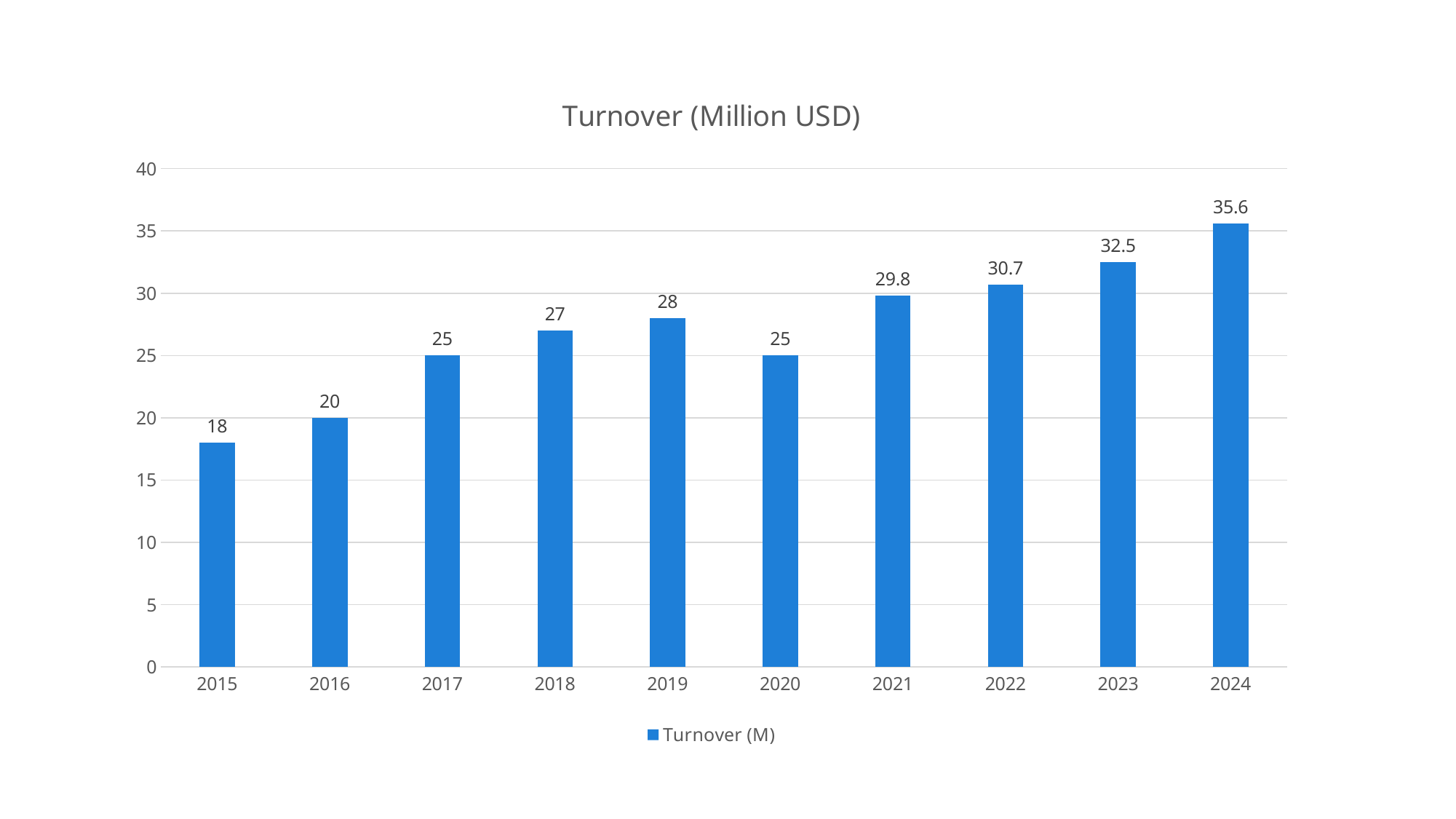
What is the turnover value for 2022? 30.7 How many years are shown on the x axis? 10 How many series does the legend list? 1 What is the difference between the turnover in 2018 and the turnover in 2015? 9 Which year has the lowest turnover? 2015 Which year has a larger turnover, 2019 or 2020? 2019 What is the turnover value for 2019? 28 What kind of chart is shown on the slide? Bar chart Is the turnover value for 2021 greater or less than 25? greater Which year has the highest turnover? 2024 What is the difference between the turnover in 2024 and the turnover in 2023? 3.1 What is the title of the chart? Turnover (Million USD)